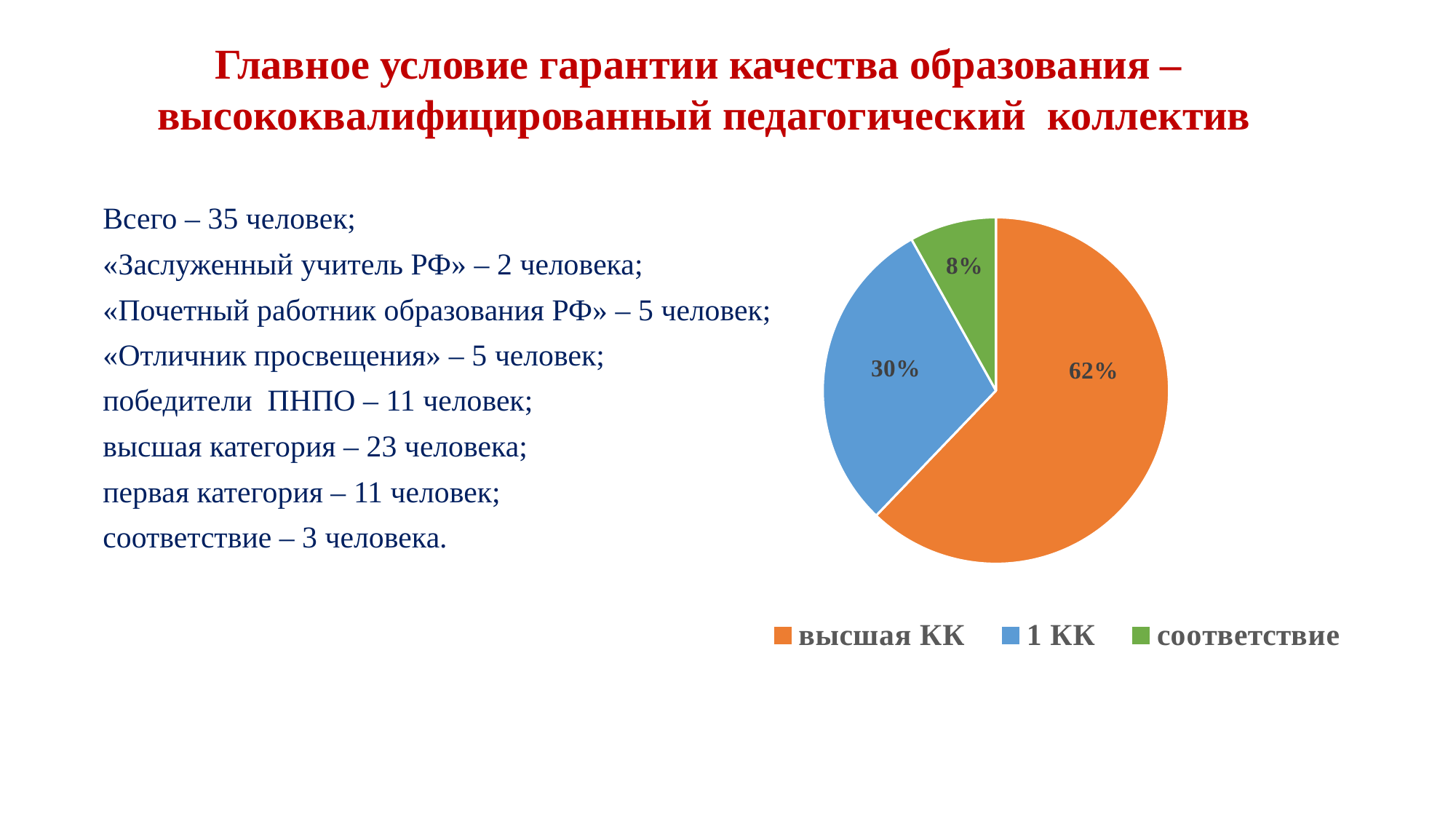
Which slice is larger, "1 КК" or "соответствие"? 1 КК How many slices does the pie chart have? 3 What is the difference in percentage points between the "высшая КК" and "1 КК" slices? 32 Which category has the smallest slice of the pie? соответствие What share of the pie does the "высшая КК" slice represent? 62% What kind of chart is shown on the slide? pie chart Which category has the largest slice of the pie? высшая КК What share of the pie does the "1 КК" slice represent? 30% What colour is the "1 КК" slice in the pie chart? blue What is the difference in percentage points between the "1 КК" and "соответствие" slices? 22 What share of the pie does the "соответствие" slice represent? 8% How many entries does the legend list? 3